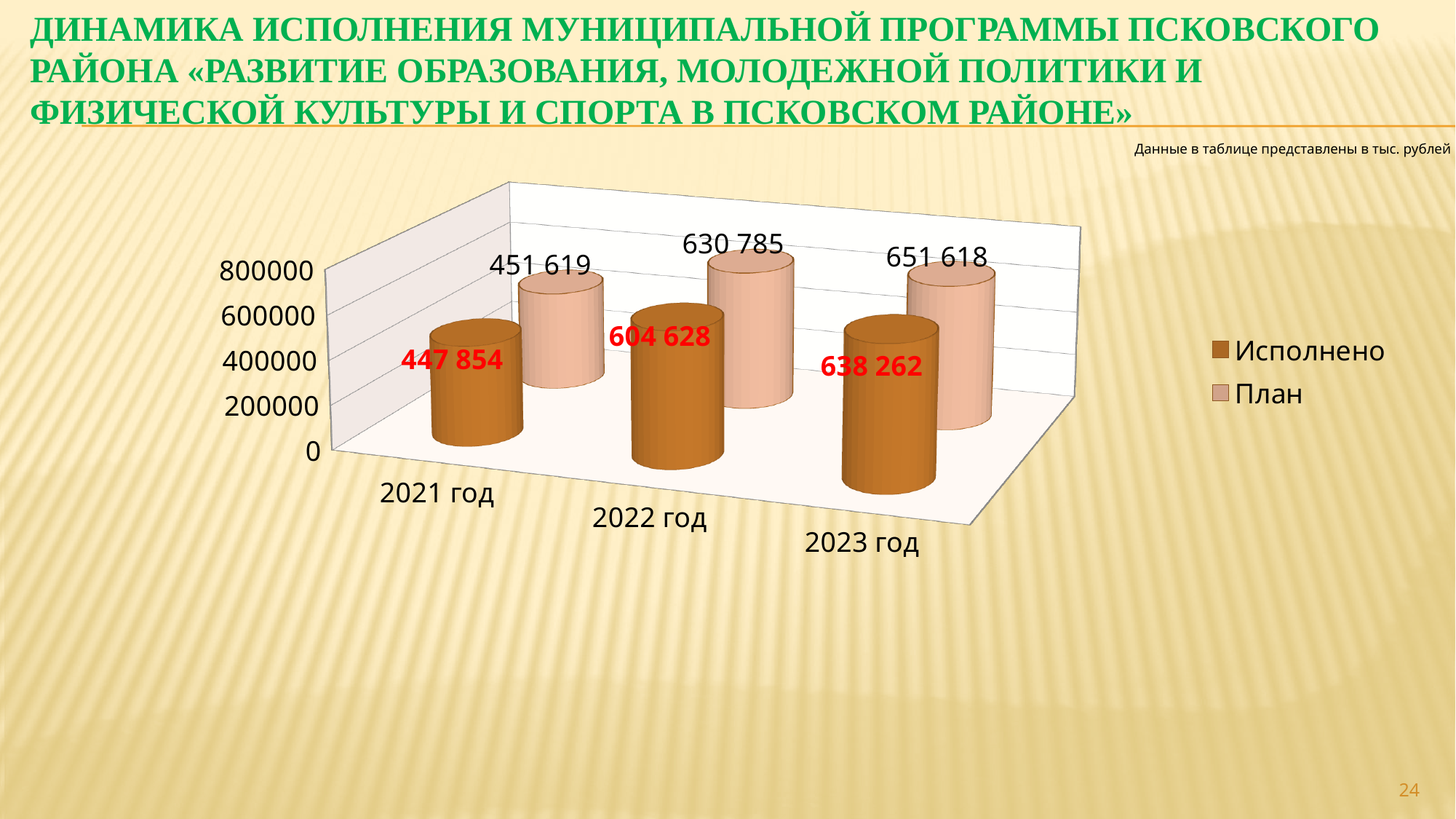
What is the value of Исполнено for 2023 год? 638 262 Which is larger for 2022 год: Исполнено or План? План Does the Исполнено value rise or fall from 2021 год to 2023 год? rise How many years are shown on the x axis of the chart? 3 In which year is the Исполнено value the highest? 2023 год How many series does the legend list? 2 What is the value of План for 2022 год? 630 785 What is the value of План for 2023 год? 651 618 What is the difference between План and Исполнено for 2023 год? 13 356 In which year is the План value the lowest? 2021 год What is the value of Исполнено for 2021 год? 447 854 What is the difference between План and Исполнено for 2022 год? 26 157